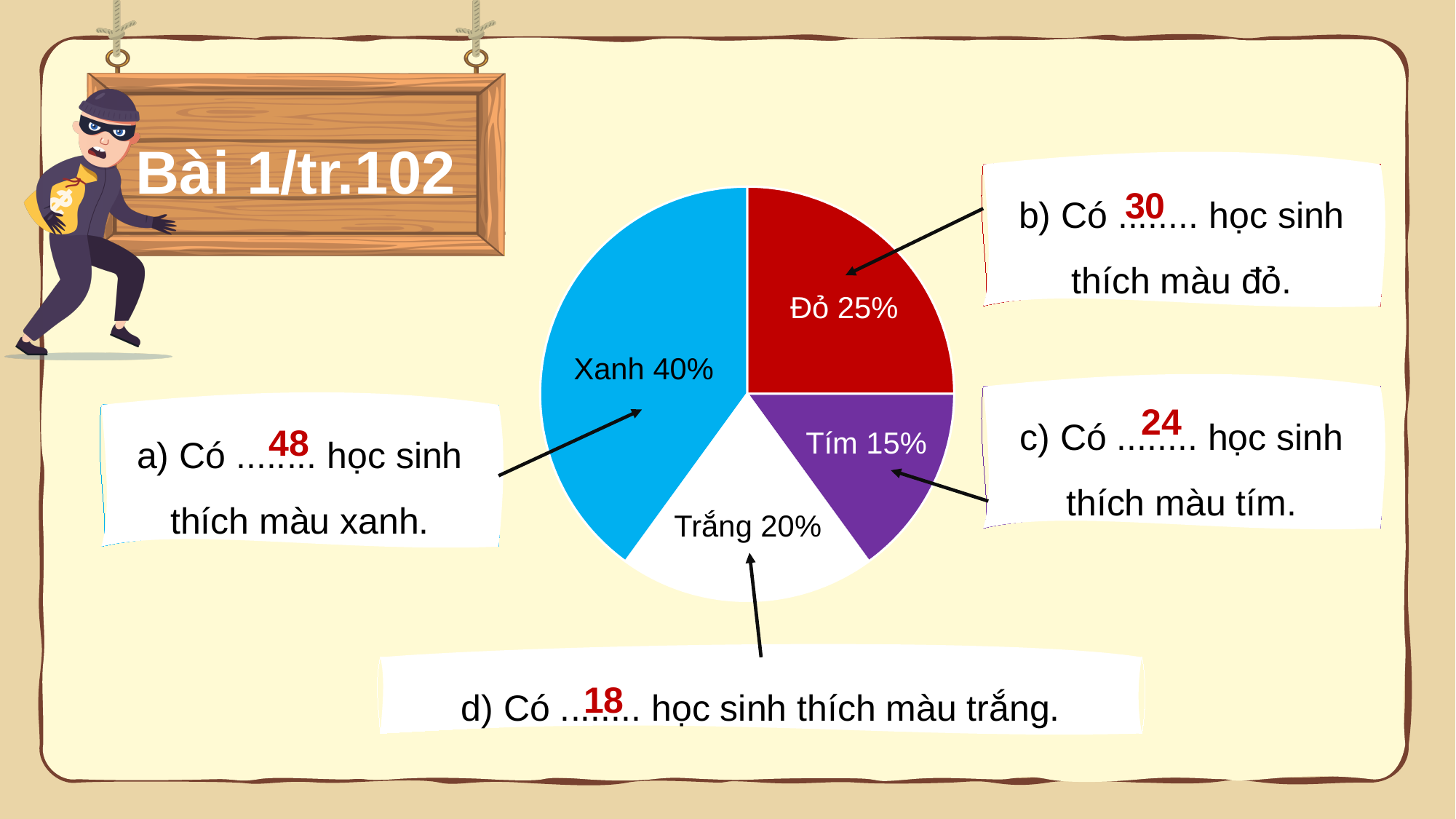
What kind of chart is shown on the slide? Pie chart What is the combined share of the Đỏ and Tím slices? 40% Which slice of the pie chart is the largest? Xanh What colour is the Tím slice of the pie chart? Purple What is the difference in percentage points between the Xanh slice and the Đỏ slice? 15 What percentage of the pie chart is labelled Tím? 15% How many slices does the pie chart have? 4 Which slice is larger, Trắng or Tím? Trắng What percentage of the pie chart is labelled Xanh? 40% What percentage of the pie chart is labelled Đỏ? 25% What percentage of the pie chart is labelled Trắng? 20% Which slice of the pie chart is the smallest? Tím